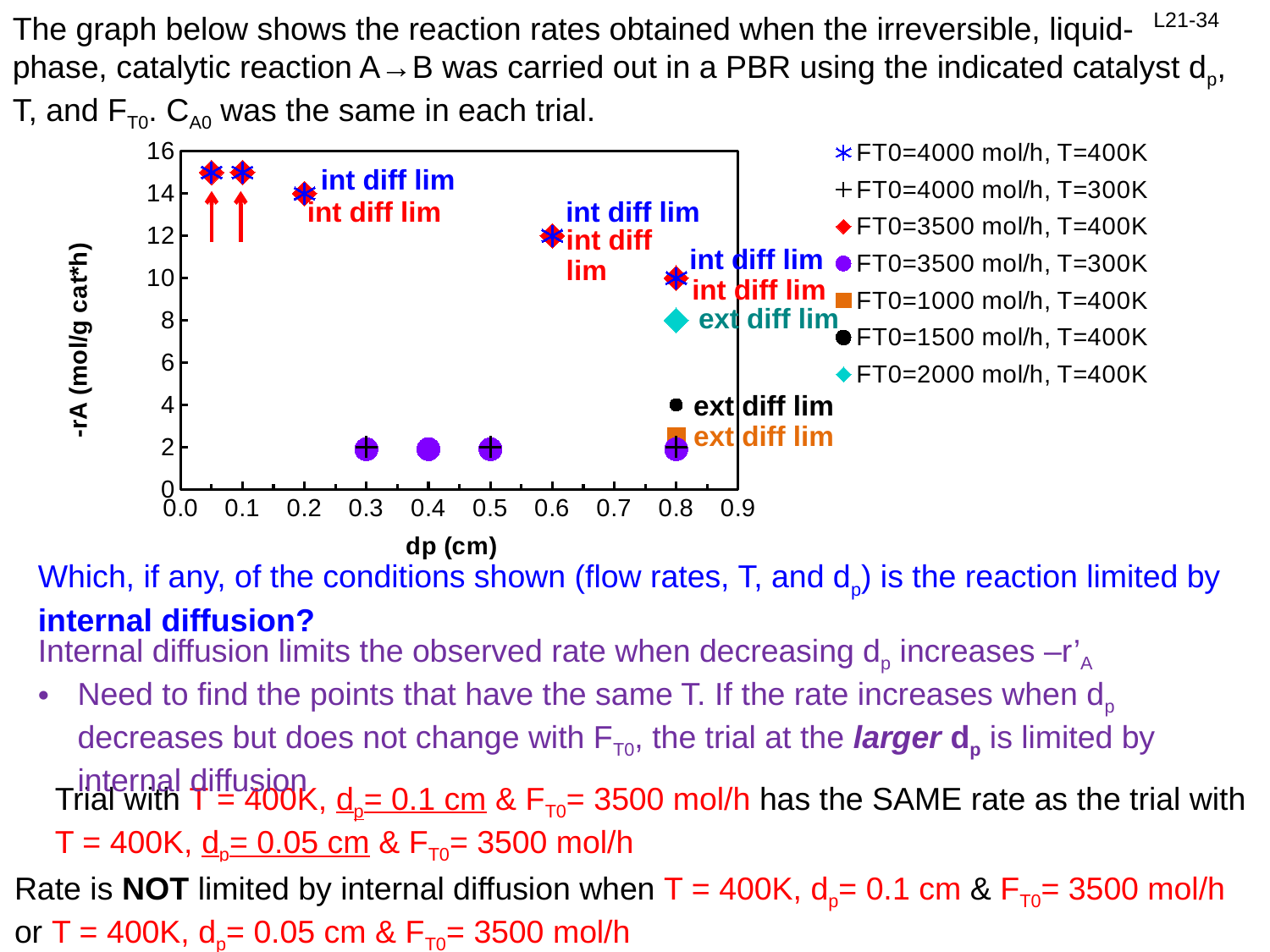
Is the value for FT0=1500 mol/h, T=400K at dp=0.8 cm greater or less than 6? less What kind of chart is shown on the slide? scatter chart Is the value for FT0=3500 mol/h, T=300K at dp=0.4 cm greater or less than 4? less Is the value for FT0=4000 mol/h, T=400K at dp=0.05 cm greater or less than 14? greater At dp=0.8 cm, which has the larger rate: FT0=2000 mol/h, T=400K or FT0=1500 mol/h, T=400K? FT0=2000 mol/h, T=400K What is the reaction rate for FT0=2000 mol/h, T=400K at dp=0.8 cm? 8 For the FT0=4000 mol/h, T=400K series, does the reaction rate rise or fall as dp increases? fall At dp=0.8 cm, which has the larger rate: FT0=4000 mol/h, T=400K or FT0=4000 mol/h, T=300K? FT0=4000 mol/h, T=400K How many series does the legend list? 7 What is the title of the vertical axis? -rA (mol/g cat*h) What is the title of the horizontal axis? dp (cm)